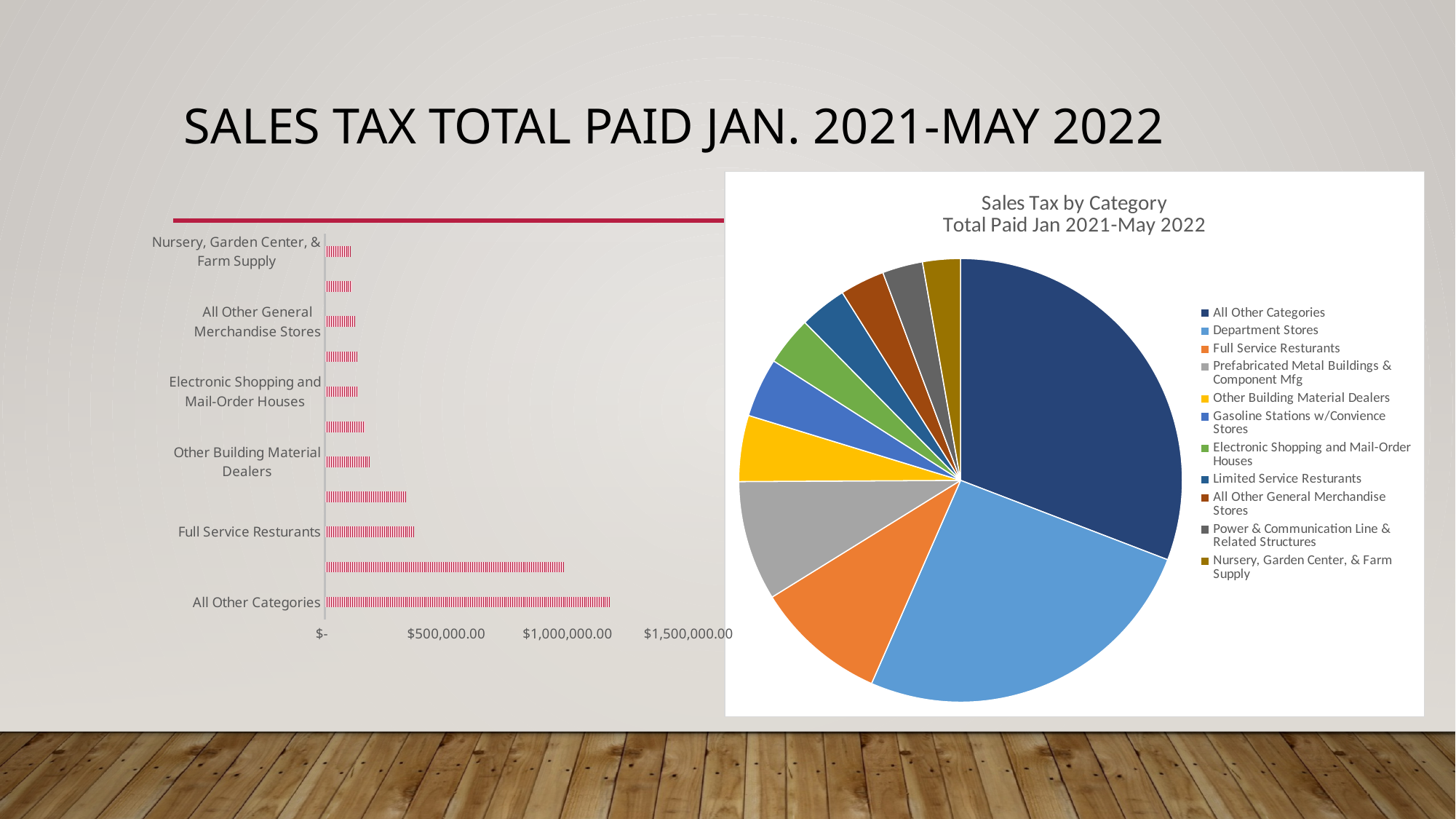
In the bar chart on the left, is the value for All Other Categories greater or less than $1,000,000.00? greater In the pie chart 'Sales Tax by Category', what colour is the slice for All Other Categories? dark blue What kind of chart is the chart on the left side of the slide? bar chart In the pie chart 'Sales Tax by Category', which category has the largest slice? All Other Categories In the bar chart on the left, is the value for Full Service Resturants greater or less than $500,000.00? less In the bar chart on the left, which category has the longest bar? All Other Categories What kind of chart is the chart titled 'Sales Tax by Category Total Paid Jan 2021-May 2022'? pie chart What is the title of the pie chart on the right side of the slide? Sales Tax by Category Total Paid Jan 2021-May 2022 In the bar chart on the left, which is larger: the value for All Other Categories or the value for Full Service Resturants? All Other Categories In the pie chart 'Sales Tax by Category', how many categories does the legend list? 11 In the bar chart on the left, how many bars are plotted? 11 In the pie chart 'Sales Tax by Category', which slice is larger: Department Stores or Other Building Material Dealers? Department Stores